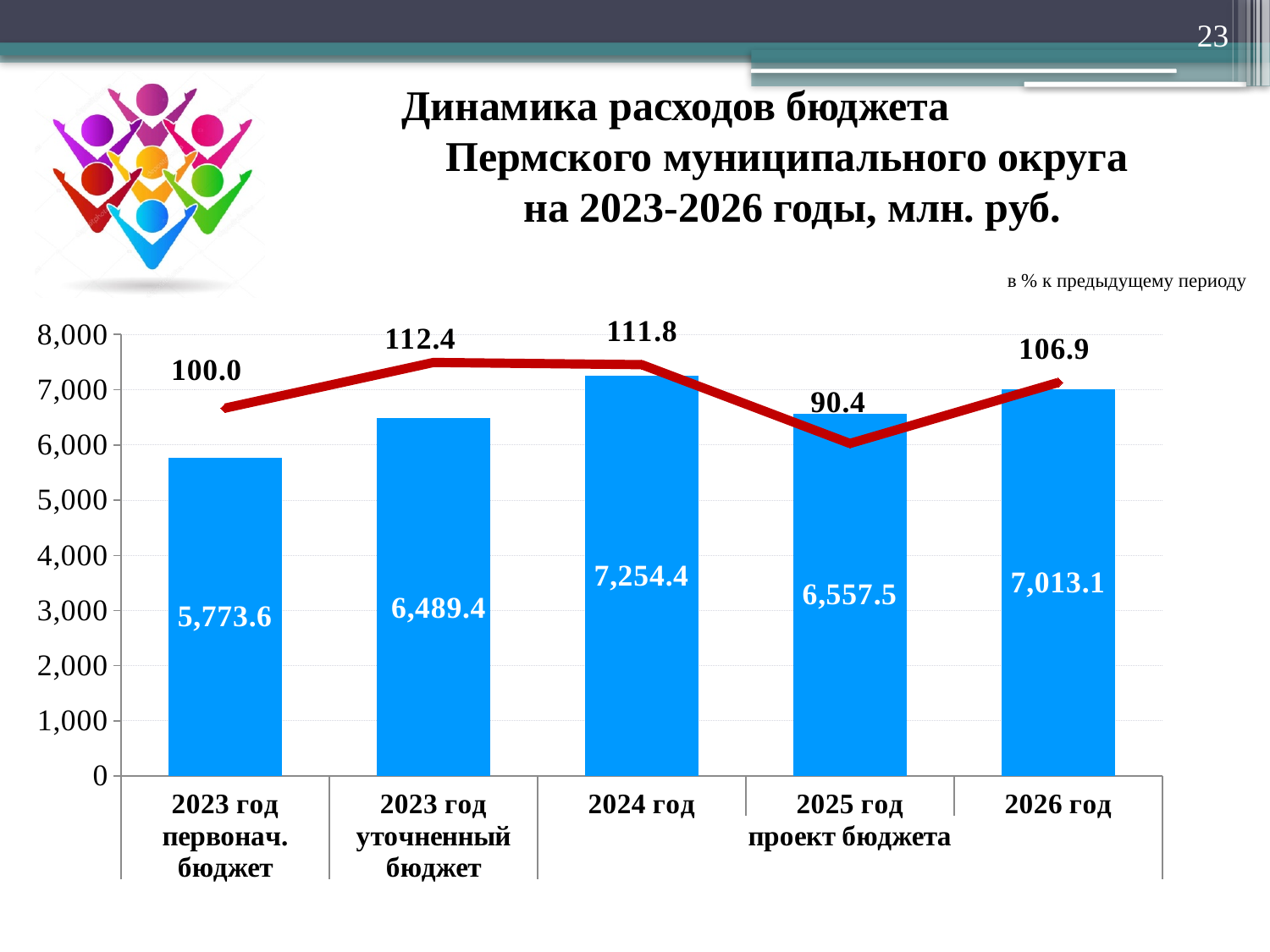
What kind of chart is shown on the slide? Combined bar and line chart What percentage to the previous period is shown on the line for 2025 год? 90.4 Which category has the lowest bar value? 2023 год первонач. бюджет Which category has the highest bar value? 2024 год What is the title of the chart? Динамика расходов бюджета Пермского муниципального округа на 2023-2026 годы, млн. руб. What is the difference between the bar values for 2023 год уточненный бюджет and 2023 год первонач. бюджет? 715.8 What is the difference between the bar values for 2024 год and 2025 год? 696.9 What percentage to the previous period is shown on the line for 2023 год уточненный бюджет? 112.4 How many categories are shown on the x axis? 5 What is the value shown for 2023 год первонач. бюджет? 5,773.6 What is the budget expenditure value for 2024 год? 7,254.4 Which is larger, the bar value for 2026 год or for 2025 год? 2026 год